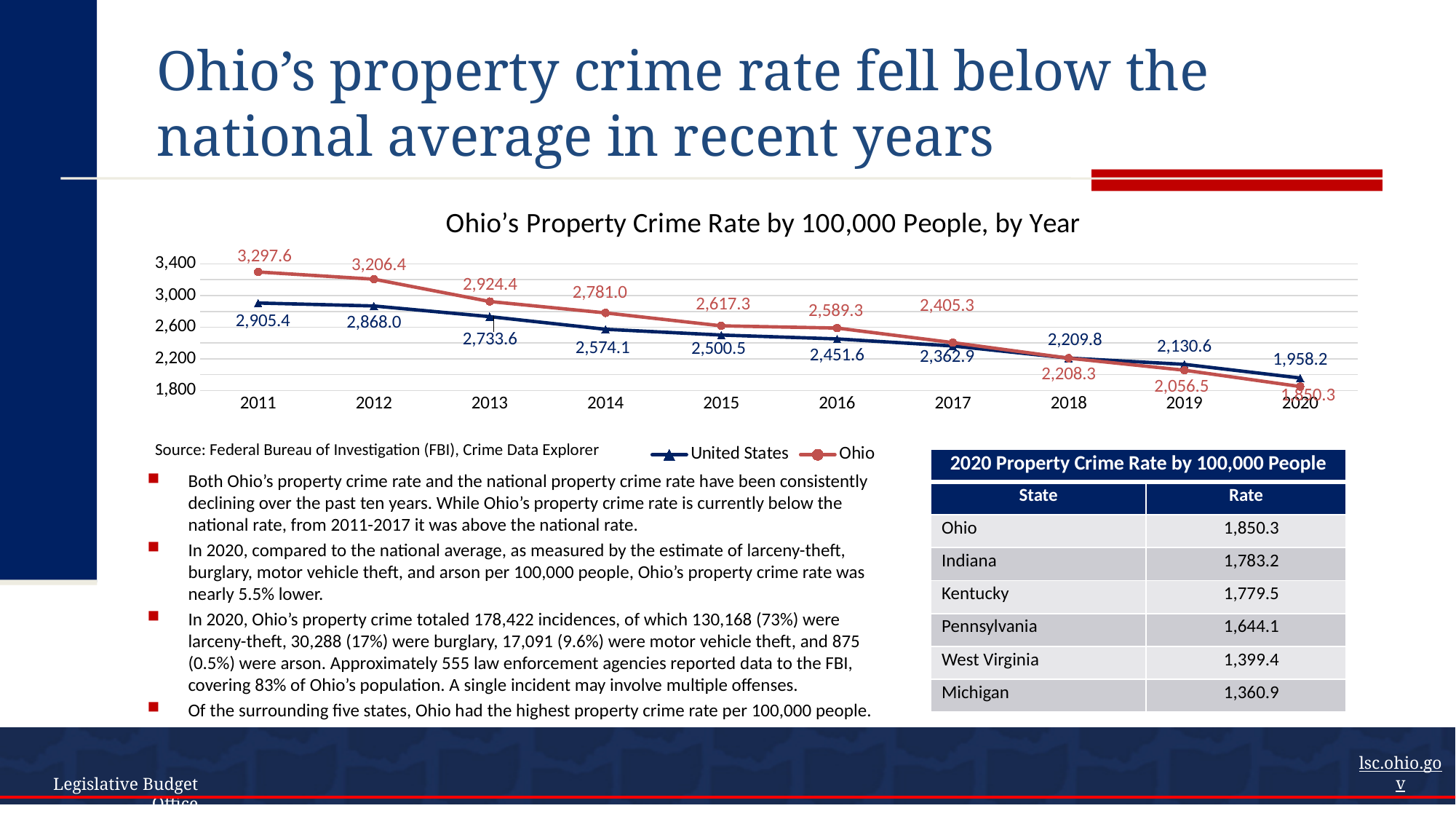
How many years are plotted on the x axis of the chart? 10 What is the title of the chart? Ohio's Property Crime Rate by 100,000 People, by Year What was the United States property crime rate in 2016? 2,451.6 In which year was the United States property crime rate highest? 2011 What was Ohio's property crime rate in 2011? 3,297.6 What was Ohio's property crime rate in 2020? 1,850.3 What type of chart is shown on the slide? line chart What is the difference between Ohio's and the United States' property crime rate in 2011? 392.2 In 2019, which was higher, the United States rate or Ohio's rate? United States How many series does the chart legend list? 2 Does Ohio's property crime rate rise or fall from 2011 to 2020? fall In which year was Ohio's property crime rate lowest? 2020